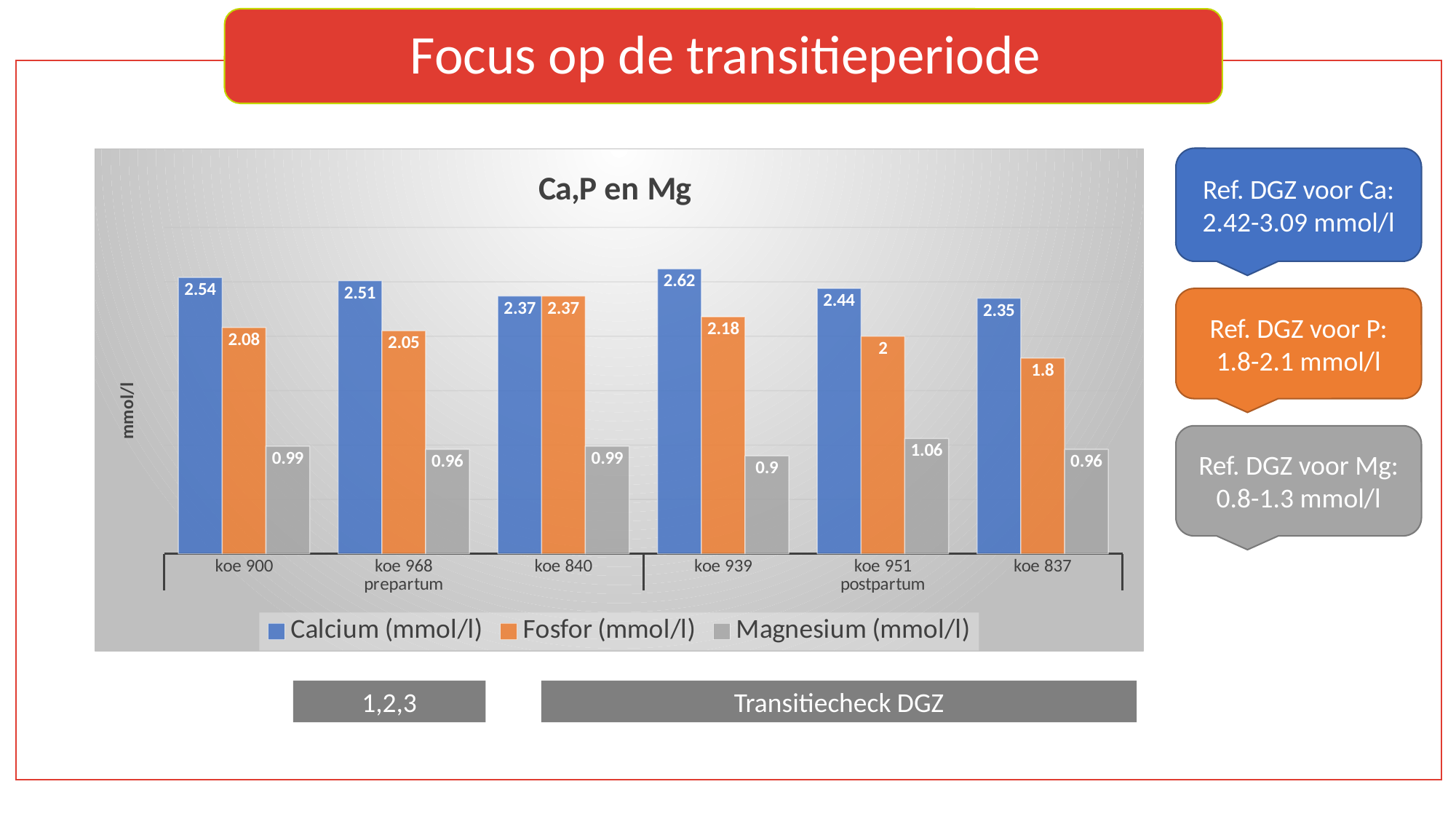
What is the Fosfor (mmol/l) value for koe 951? 2 Which cow has the highest Magnesium (mmol/l) value? koe 951 What is the Calcium (mmol/l) value for koe 900? 2.54 What kind of chart is shown? bar chart What is the difference between the Calcium (mmol/l) values for koe 939 and koe 837? 0.27 What is the title of the chart? Ca,P en Mg What is the Magnesium (mmol/l) value for koe 939? 0.9 Which cow has the lowest Fosfor (mmol/l) value? koe 837 How many cows (categories) are shown on the x axis? 6 Which cow has the highest Calcium (mmol/l) value? koe 939 How many series does the legend list? 3 Which is larger, the Fosfor (mmol/l) value for koe 900 or for koe 968? koe 900